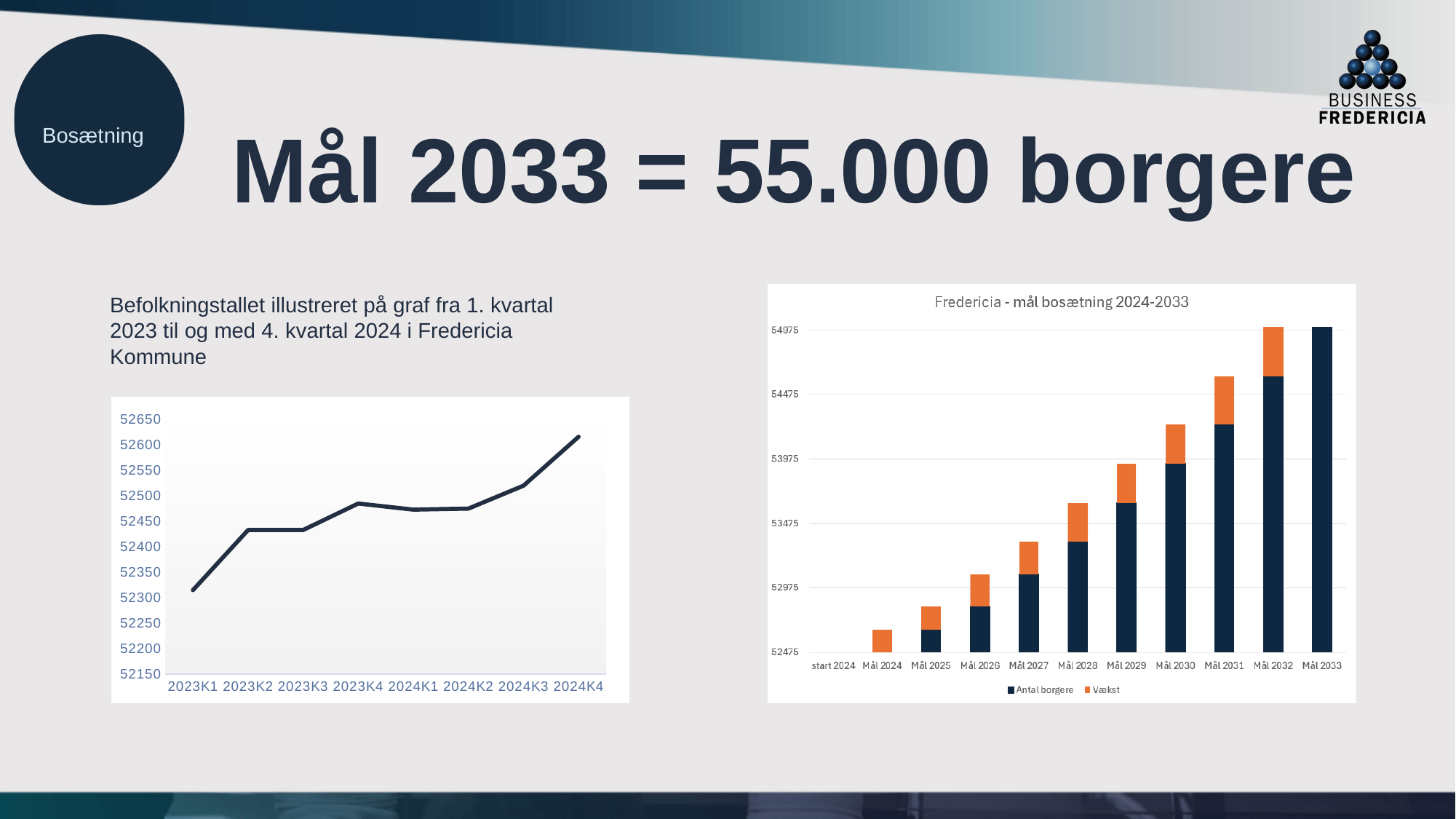
What kind of chart is the chart on the left of the slide? line chart How many categories are shown on the x axis of 'Fredericia - mål bosætning 2024-2033'? 11 On the left line chart, do the values rise or fall from 2023K1 to 2024K4? rise In 'Fredericia - mål bosætning 2024-2033', is the total for Mål 2033 greater or less than 54475? greater In 'Fredericia - mål bosætning 2024-2033', which bar is taller, Mål 2030 or Mål 2026? Mål 2030 How many series does the legend of 'Fredericia - mål bosætning 2024-2033' list? 2 On the left line chart, is the value for 2024K4 greater or less than 52600? greater On the left line chart, which quarter has the lowest value? 2023K1 What kind of chart is 'Fredericia - mål bosætning 2024-2033'? bar chart On the left line chart, is the value for 2023K1 greater or less than 52350? less On the left line chart, which quarter has the highest value? 2024K4 How many quarters are plotted on the left line chart? 8